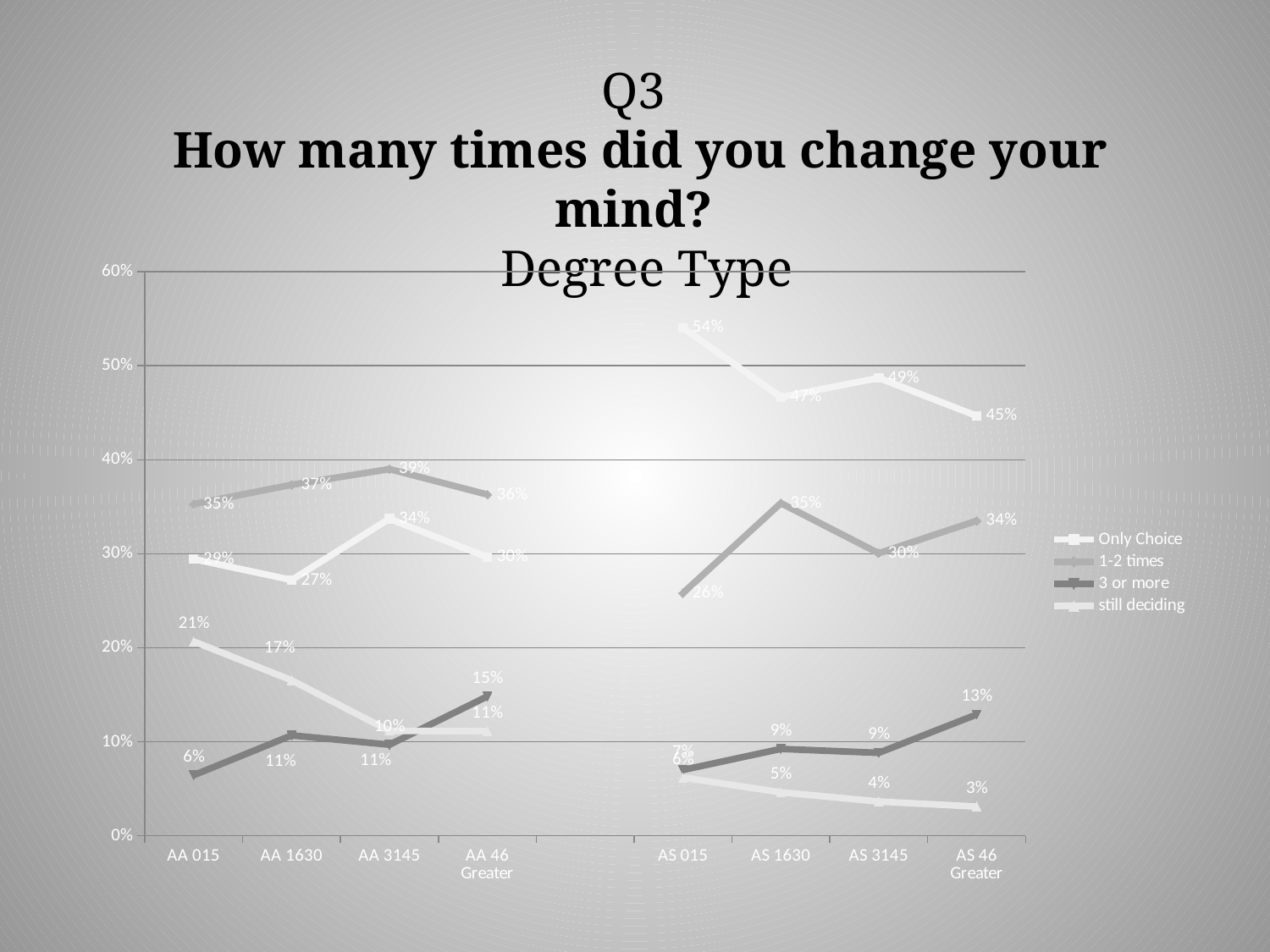
What is the value for still deciding at AA 015? 21% What is the value for 1-2 times at AA 3145? 39% For the 1-2 times series, which is larger: the value at AS 1630 or at AS 3145? AS 1630 What is the difference between the Only Choice values at AS 015 and AS 46 Greater? 9 percentage points What is the value for 3 or more at AS 46 Greater? 13% What is the value for Only Choice at AS 015? 54% Does the still deciding series rise or fall from AS 015 to AS 46 Greater? Fall At which category does the still deciding series have its lowest value? AS 46 Greater At which category does the Only Choice series reach its highest value? AS 015 What kind of chart is shown on the slide? Line chart How many series does the legend list? 4 What is the title of the chart? Degree Type